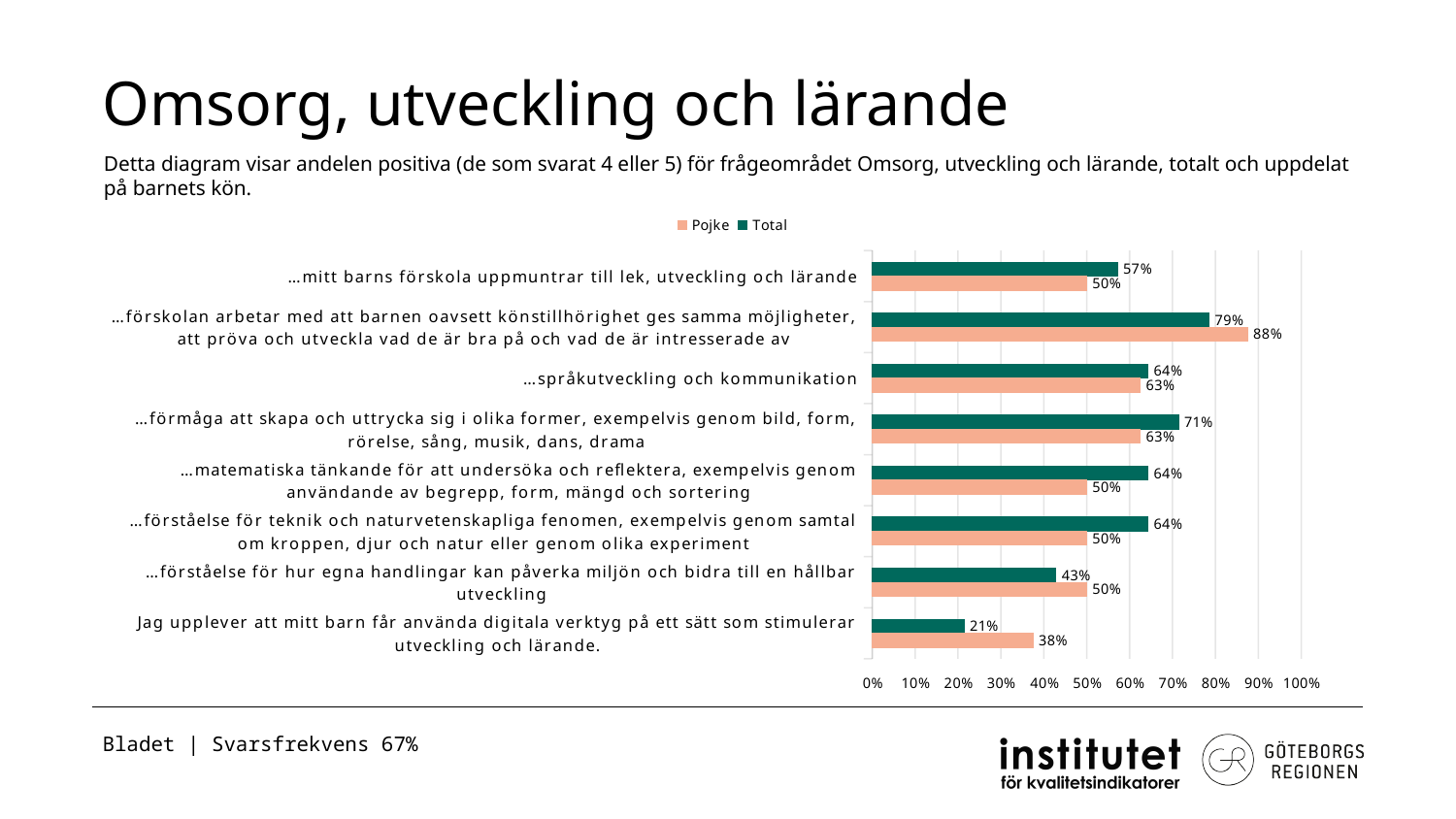
What is the Pojke value for "…förskolan arbetar med att barnen oavsett könstillhörighet ges samma möjligheter, att pröva och utveckla vad de är bra på och vad de är intresserade av"? 88% What is the difference between the Total and Pojke values for "…förmåga att skapa och uttrycka sig i olika former, exempelvis genom bild, form, rörelse, sång, musik, dans, drama"? 8 percentage points How many categories are shown in the chart? 8 What kind of chart is shown on the slide? Bar chart Which series is shown in dark green in the legend? Total What is the Total value for "Jag upplever att mitt barn får använda digitala verktyg på ett sätt som stimulerar utveckling och lärande."? 21% Which category has the highest Total value? …förskolan arbetar med att barnen oavsett könstillhörighet ges samma möjligheter, att pröva och utveckla vad de är bra på och vad de är intresserade av What is the Total value for "…språkutveckling och kommunikation"? 64% What is the Pojke value for "…förståelse för hur egna handlingar kan påverka miljön och bidra till en hållbar utveckling"? 50% For "…mitt barns förskola uppmuntrar till lek, utveckling och lärande", which is larger, the Total value or the Pojke value? Total Which category has the lowest Pojke value? Jag upplever att mitt barn får använda digitala verktyg på ett sätt som stimulerar utveckling och lärande. How many series does the legend list? 2